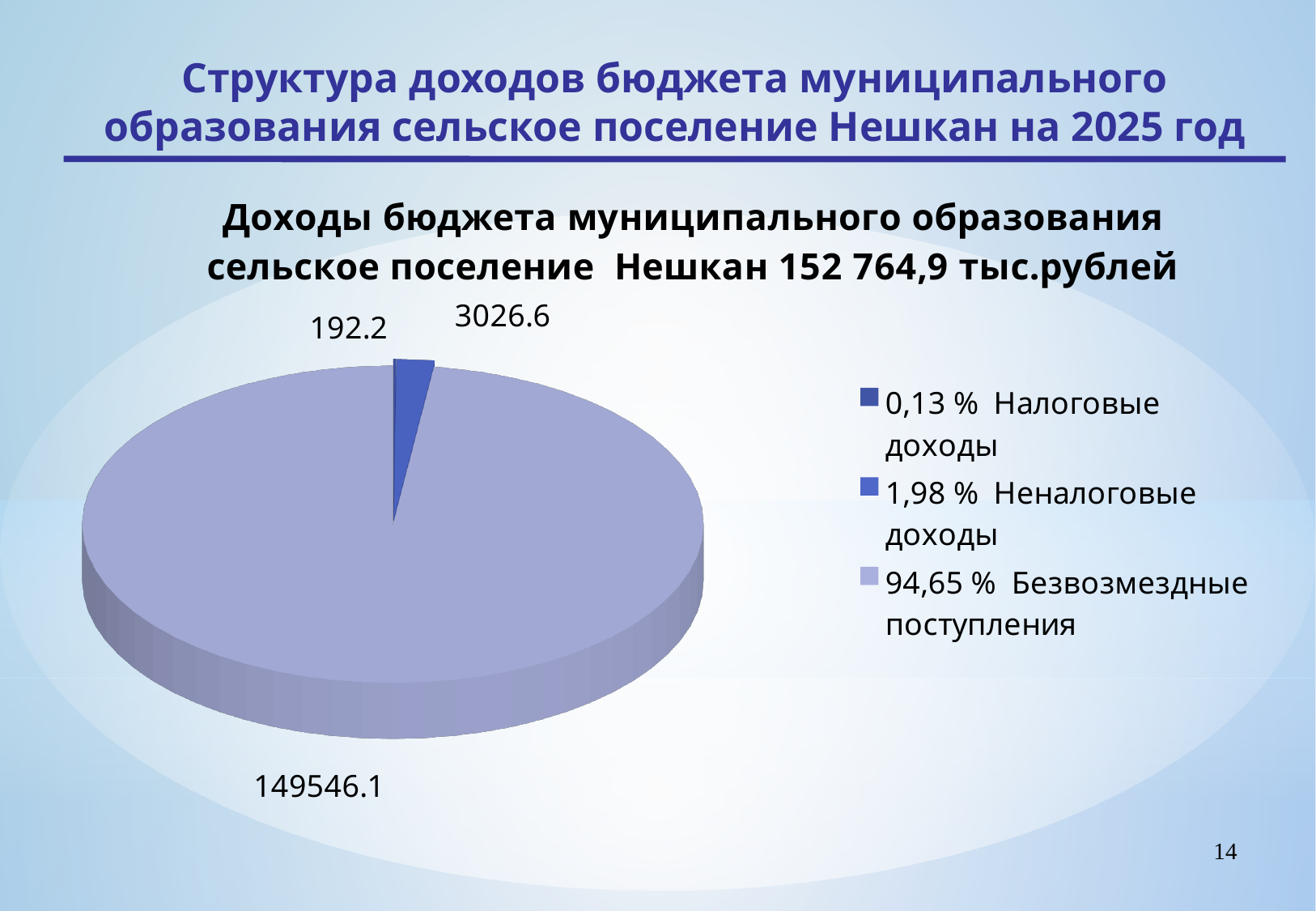
What is the value shown for Безвозмездные поступления? 149546.1 What share of the pie does Безвозмездные поступления represent, according to the legend? 94,65 % What share of the pie does Неналоговые доходы represent, according to the legend? 1,98 % What is the value shown for Налоговые доходы? 192.2 How many slices does the pie chart have? 3 How many entries does the legend list? 3 What is the value shown for Неналоговые доходы? 3026.6 Which category has the smallest slice of the pie? Налоговые доходы What kind of chart is shown on the slide? pie chart What is the difference between the values for Неналоговые доходы and Налоговые доходы? 2834.4 Which is larger, the value for Неналоговые доходы or the value for Налоговые доходы? Неналоговые доходы Which category has the largest slice of the pie? Безвозмездные поступления